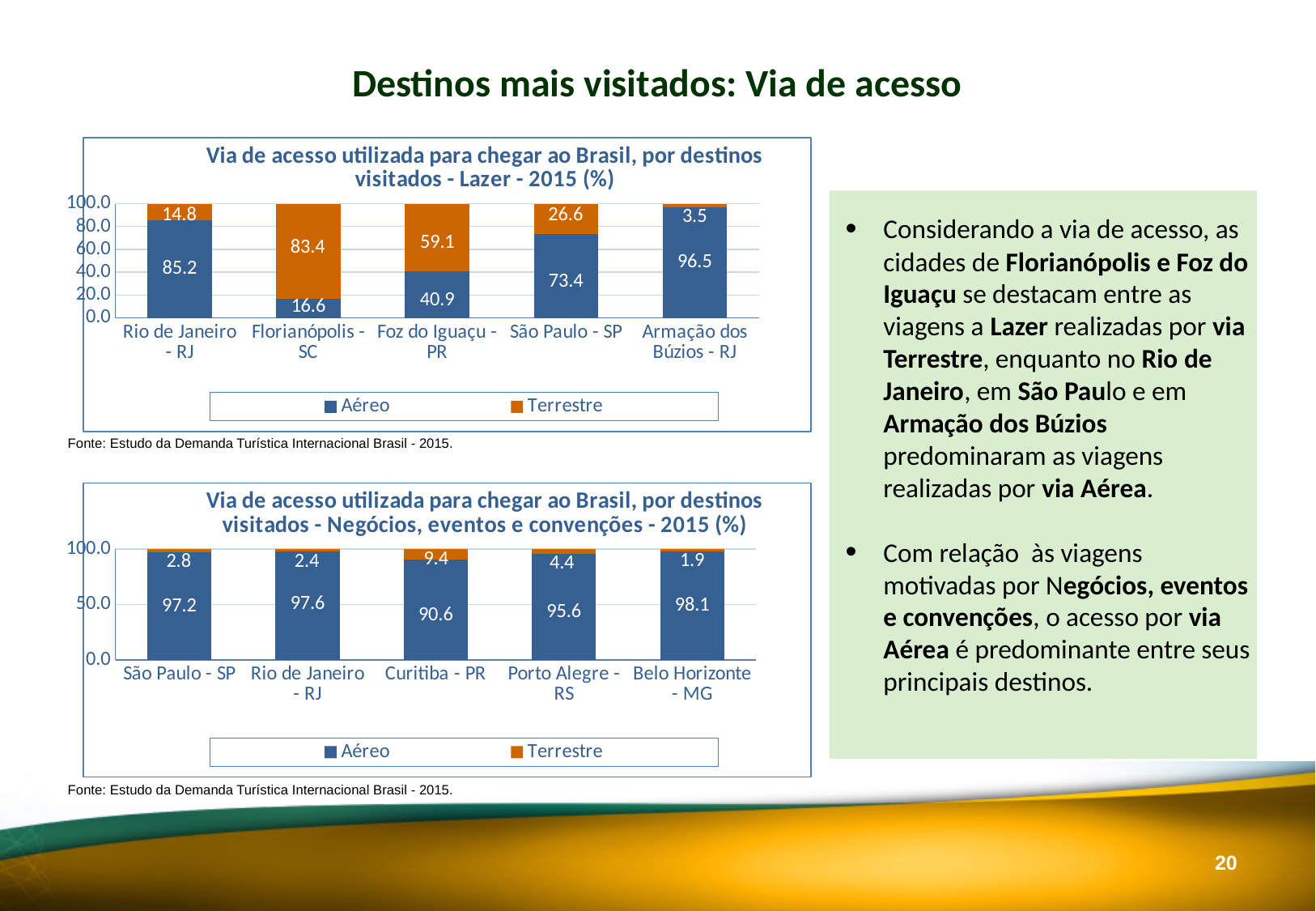
How many destinations are shown in the bottom chart (Negócios, eventos e convenções - 2015)? 5 In the bottom chart (Negócios, eventos e convenções - 2015), which destination has the highest Terrestre value? Curitiba - PR In the top chart (Lazer - 2015), what is the difference between the Terrestre values for Florianópolis - SC and Foz do Iguaçu - PR? 24.3 In the top chart (Lazer - 2015), what is the Aéreo value for Florianópolis - SC? 16.6 How many series does the legend of the top chart (Lazer - 2015) list? 2 In the top chart (Lazer - 2015), is the Aéreo value for Rio de Janeiro - RJ or for São Paulo - SP larger? Rio de Janeiro - RJ What type of chart is the top chart (Lazer - 2015)? Stacked bar chart In the top chart (Lazer - 2015), what is the Terrestre value for São Paulo - SP? 26.6 In the bottom chart (Negócios, eventos e convenções - 2015), what is the total of the stacked bar for Belo Horizonte - MG? 100.0 In the bottom chart (Negócios, eventos e convenções - 2015), what is the Aéreo value for Curitiba - PR? 90.6 In the top chart (Lazer - 2015), which destination has the highest Aéreo value? Armação dos Búzios - RJ In the top chart (Lazer - 2015), which destination has the lowest Terrestre value? Armação dos Búzios - RJ